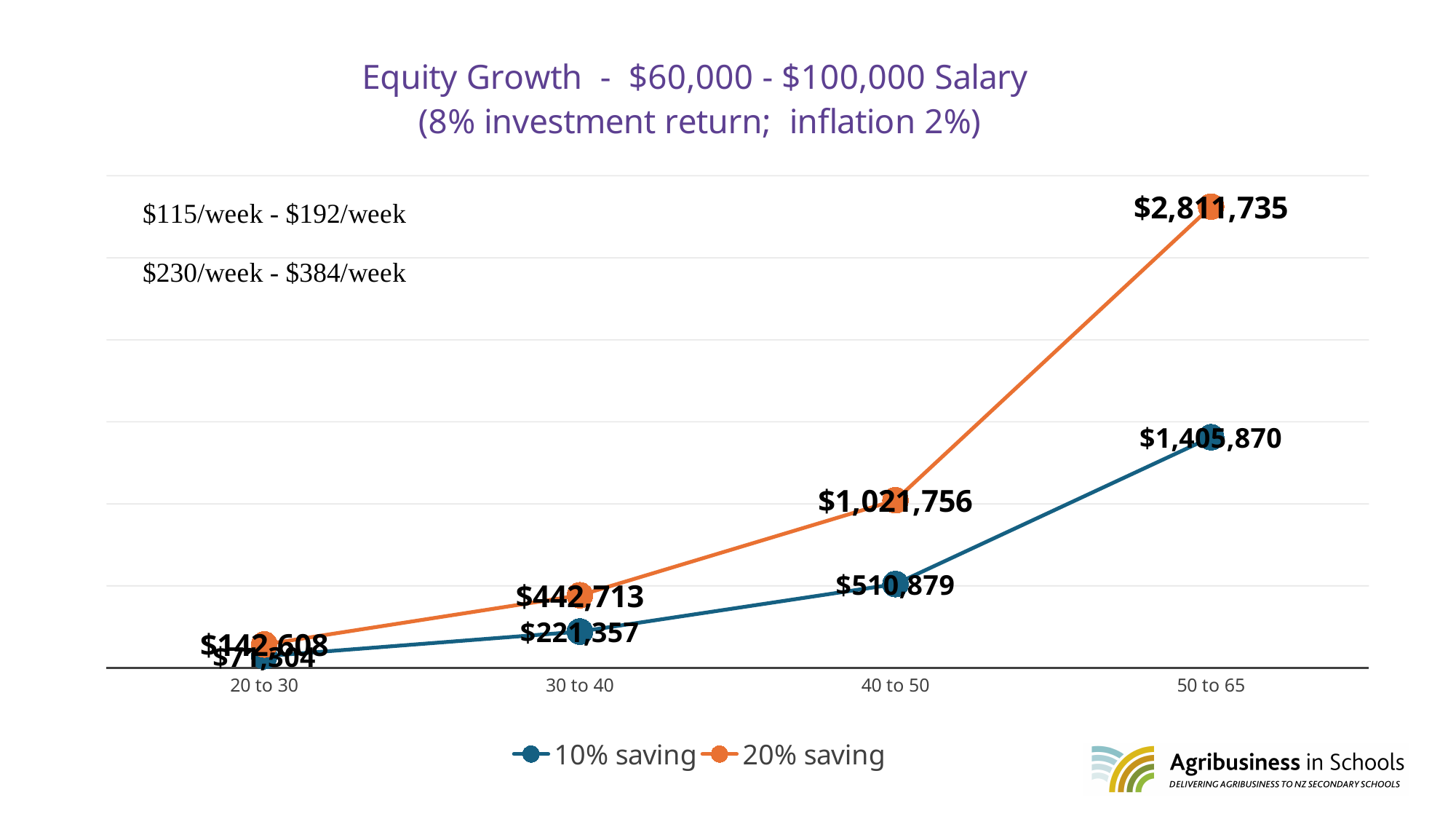
What is the value for the 10% saving series at 50 to 65? $1,405,870 Which age range has the lowest value for the 10% saving series? 20 to 30 What is the value for the 20% saving series at 40 to 50? $1,021,756 How many series does the legend list? 2 What is the difference between the 20% saving and 10% saving values at 40 to 50? $510,877 What is the value for the 10% saving series at 40 to 50? $510,879 What is the value for the 20% saving series at 30 to 40? $442,713 Which is larger at 30 to 40: the 10% saving value or the 20% saving value? 20% saving What is the value for the 20% saving series at 50 to 65? $2,811,735 How many age ranges are shown on the x axis? 4 What is the difference between the 20% saving and 10% saving values at 50 to 65? $1,405,865 Which age range has the highest value for the 20% saving series? 50 to 65